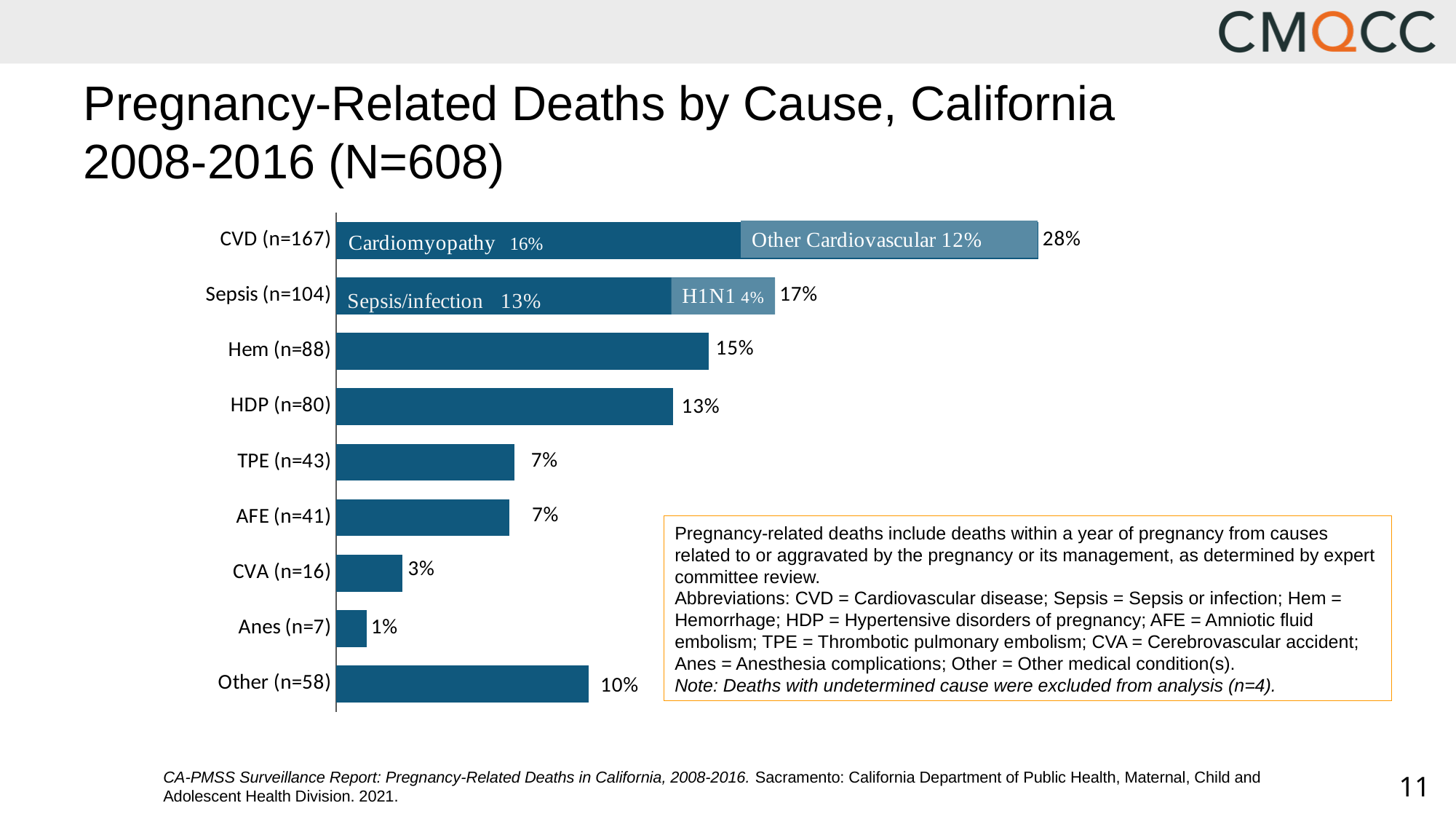
Which cause category has the lowest percentage of pregnancy-related deaths? Anes (n=7) What percentage is shown for the H1N1 segment of the Sepsis bar? 4% What percentage is shown for the Cardiomyopathy segment of the CVD bar? 16% What is the total percentage of the Sepsis (n=104) bar, combining Sepsis/infection and H1N1? 17% What is the title of the slide containing the chart? Pregnancy-Related Deaths by Cause, California 2008-2016 (N=608) What is the difference in percentage points between CVD (n=167) and Sepsis (n=104)? 11 Which has a larger percentage, HDP (n=80) or Other (n=58)? HDP (n=80) What kind of chart is shown on the slide? Bar chart What percentage is shown for Hem (n=88)? 15% What percentage of pregnancy-related deaths is shown for CVD (n=167)? 28% How many cause categories are plotted on the chart? 9 Which cause category has the highest percentage of pregnancy-related deaths? CVD (n=167)